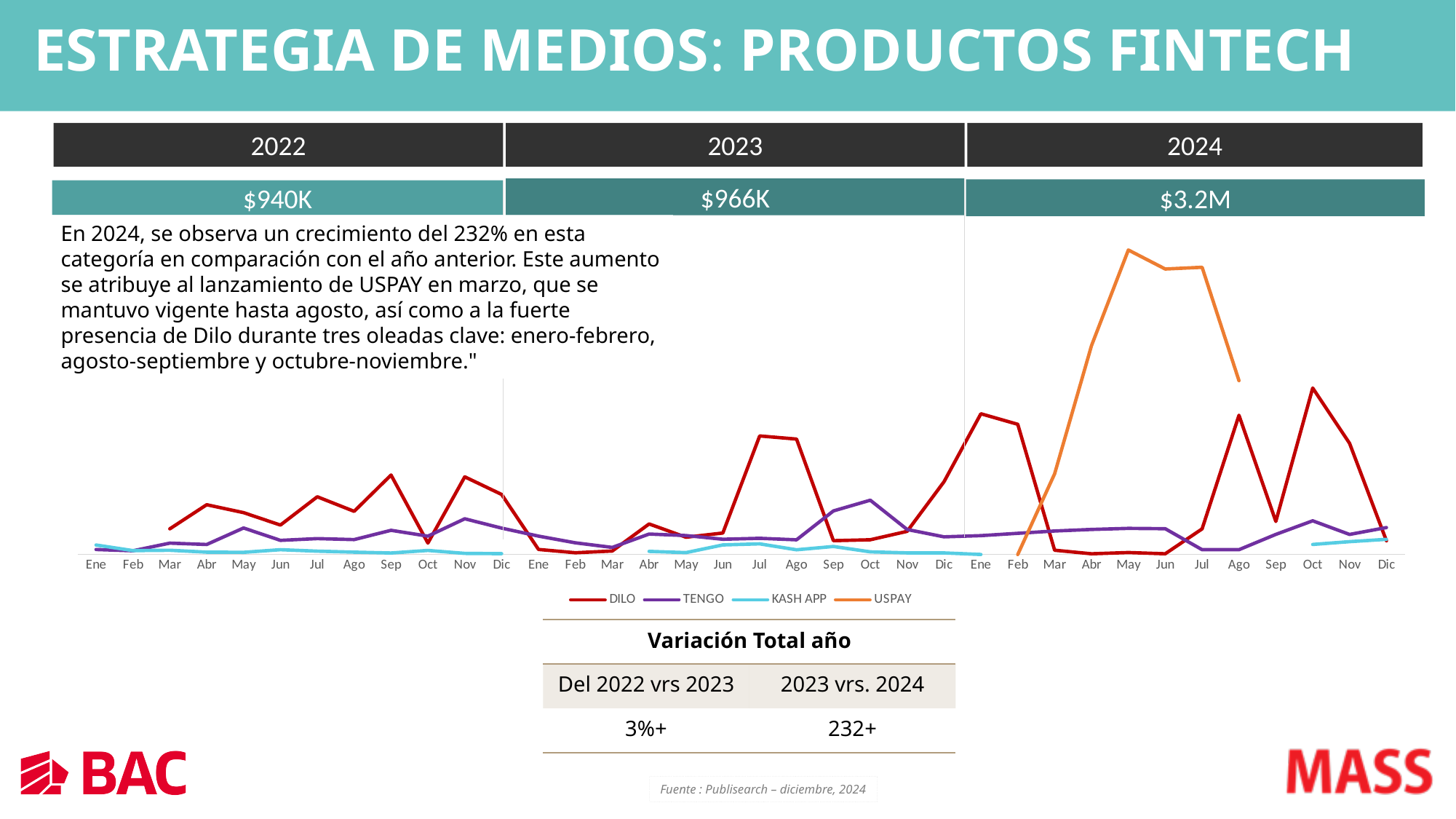
In which year does the USPAY line first appear on the chart? 2024 What kind of chart is shown on the slide? line chart Which series are listed in the chart legend? DILO, TENGO, KASH APP, USPAY Which series reaches the highest point on the chart? USPAY In 2024, which is higher in May: the USPAY line or the DILO line? USPAY In which month and year does the USPAY line reach its peak? May 2024 How many series does the chart legend list? 4 What total is shown for 2022 above the chart? $940K What total is shown for 2024 above the chart? $3.2M How many years does the chart cover? 3 In 2023, which is higher in July: the DILO line or the TENGO line? DILO Which series stays lowest across the chart? KASH APP